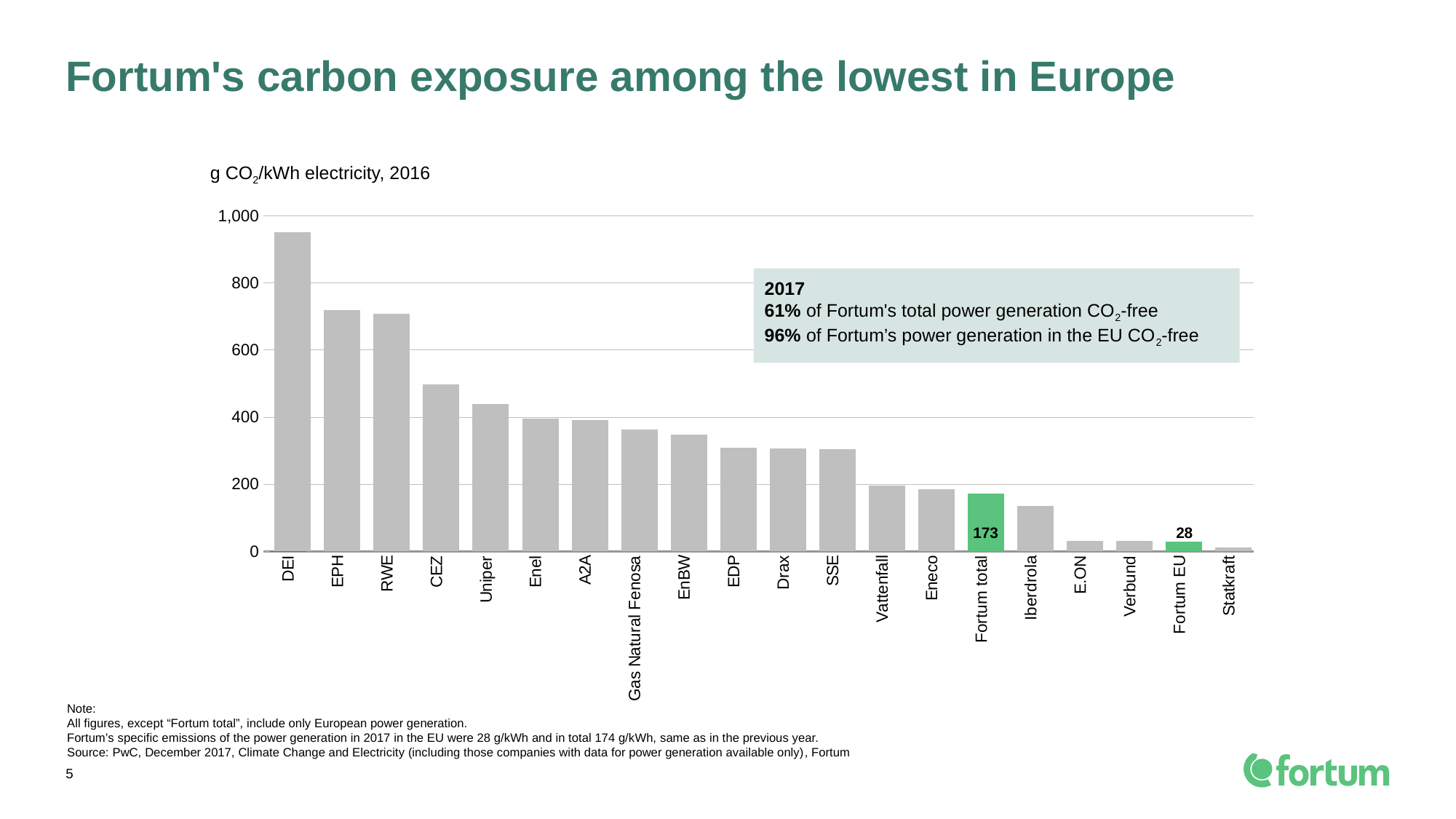
Is the value for CEZ greater or less than 400? greater Which is larger, the value for Eneco or the value for Iberdrola? Eneco Which company has the lowest g CO2/kWh value? Statkraft What is the difference between the values for Fortum total and Fortum EU? 145 Is the value for DEI greater or less than 800? greater Which is larger, the value for DEI or the value for EPH? DEI What type of chart is shown on the slide? bar chart Do the values rise or fall from left to right along the x axis? fall Which company has the highest g CO2/kWh value? DEI How many companies are shown on the x axis? 20 What is the value for Fortum EU? 28 What is the value for Fortum total? 173